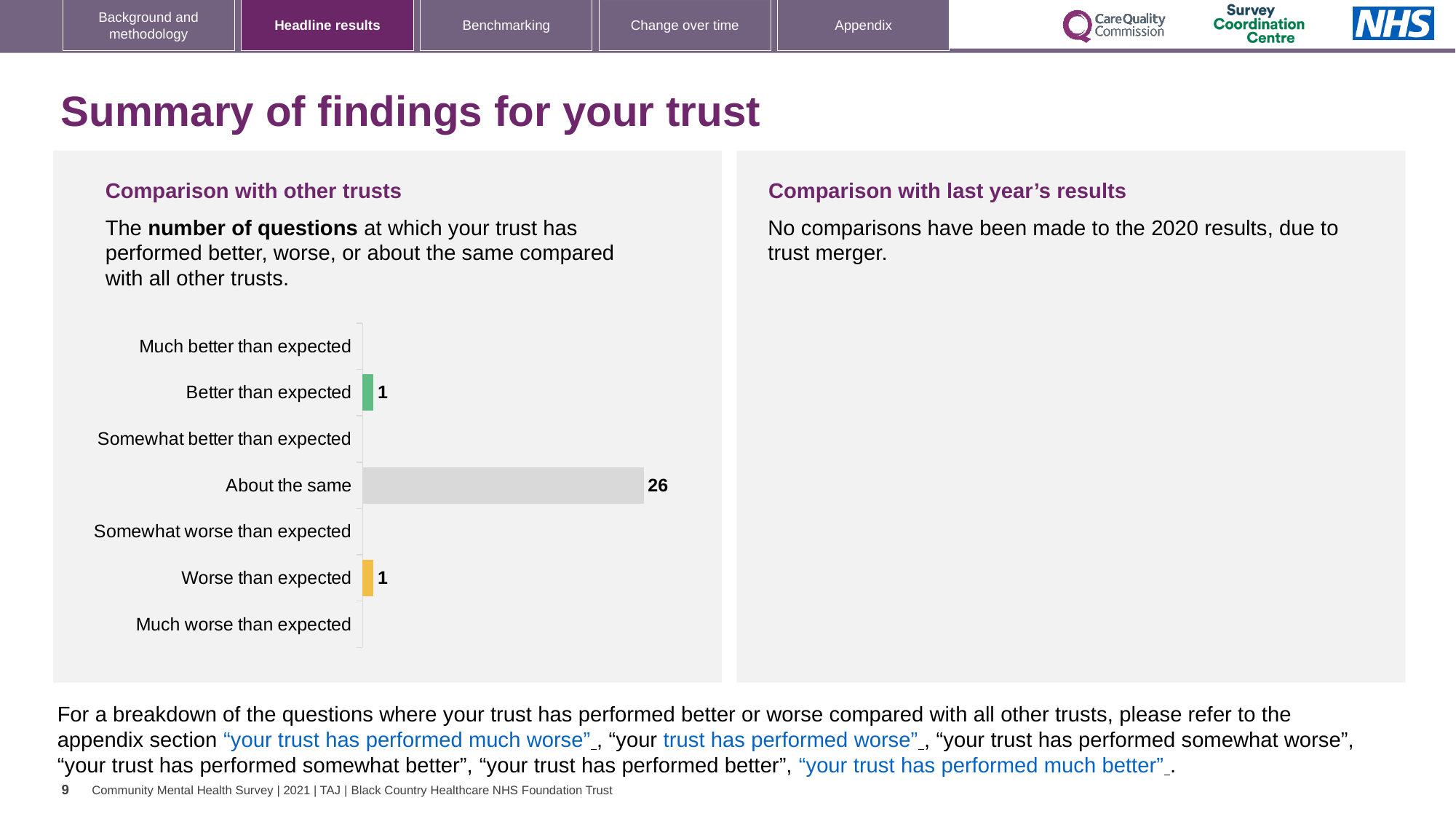
Which is larger, the value for "About the same" or the value for "Worse than expected"? About the same What is the value for "Better than expected"? 1 How many categories have a visible bar on the chart? 3 Which category has the highest value? About the same What is the value for "Worse than expected"? 1 How many categories are listed on the chart's axis? 7 What colour is the bar for "Worse than expected"? Yellow What is the difference between the values for "About the same" and "Worse than expected"? 25 What kind of chart is shown on the slide? Bar chart What is the value for "About the same"? 26 What colour is the bar for "Better than expected"? Green What is the difference between the values for "About the same" and "Better than expected"? 25